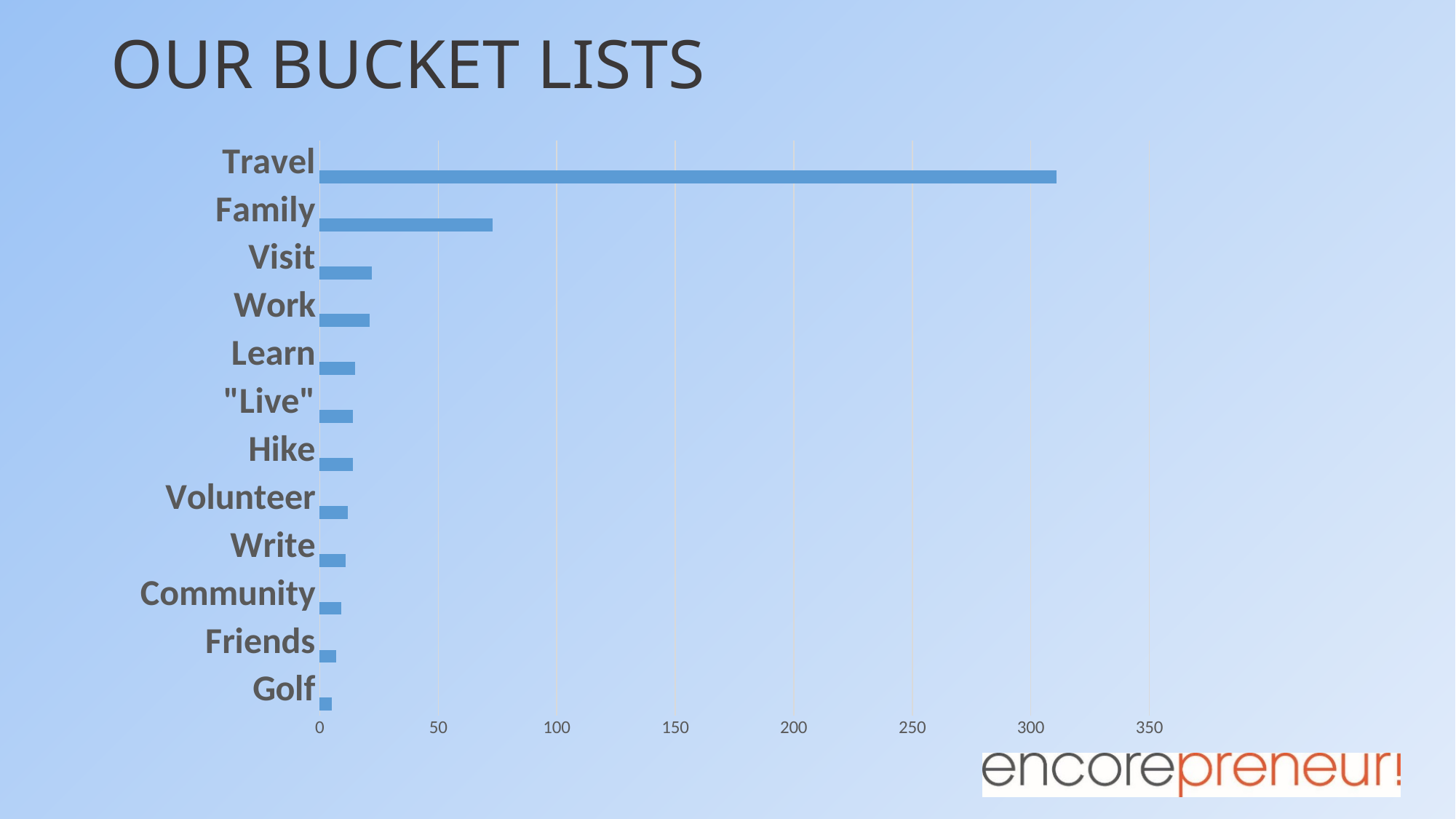
Which has a larger value, Travel or Family? Travel What is the title of the slide containing the chart? OUR BUCKET LISTS What kind of chart is shown on the slide? bar chart Is the value for Travel greater or less than 300? greater Which category has the highest value in the chart? Travel Is the value for Visit greater or less than 50? less Is the value for Family greater or less than 100? less Which category has the lowest value in the chart? Golf Which has a larger value, Family or Visit? Family How many categories are plotted in the chart? 12 Which has a larger value, Golf or Visit? Visit